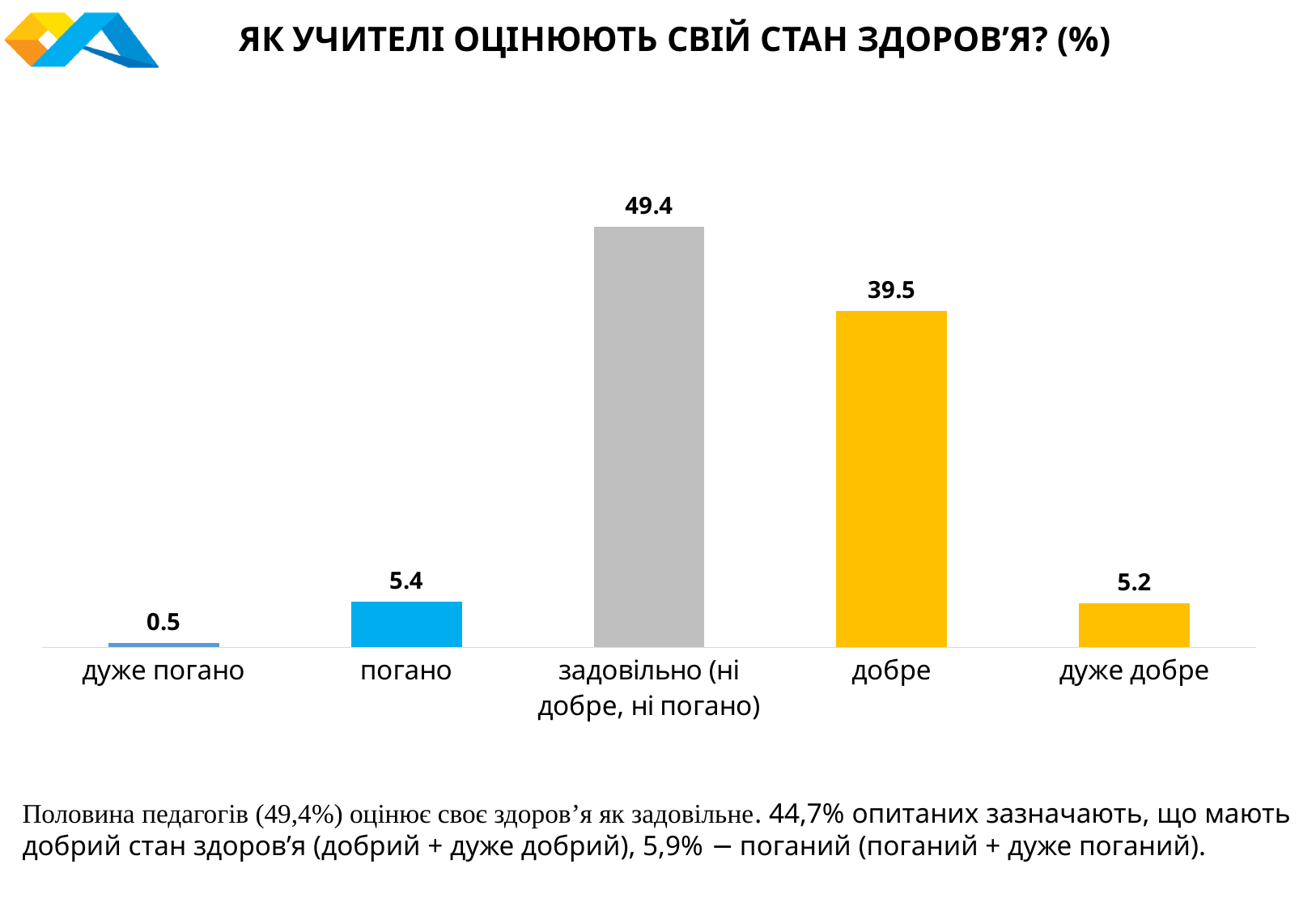
What is the value for "добре"? 39.5 Which category has the lowest value? дуже погано Which is larger, the value for "добре" or the value for "дуже добре"? добре What kind of chart is shown on the slide? bar chart What colour is the bar for "задовільно (ні добре, ні погано)"? grey What is the difference between the values for "задовільно (ні добре, ні погано)" and "добре"? 9.9 How many categories are shown on the x axis? 5 Which category has the highest value? задовільно (ні добре, ні погано) What is the title of the chart? ЯК УЧИТЕЛІ ОЦІНЮЮТЬ СВІЙ СТАН ЗДОРОВ'Я? (%) What is the difference between the values for "погано" and "дуже добре"? 0.2 What is the value for "погано"? 5.4 What is the value for "дуже погано"? 0.5